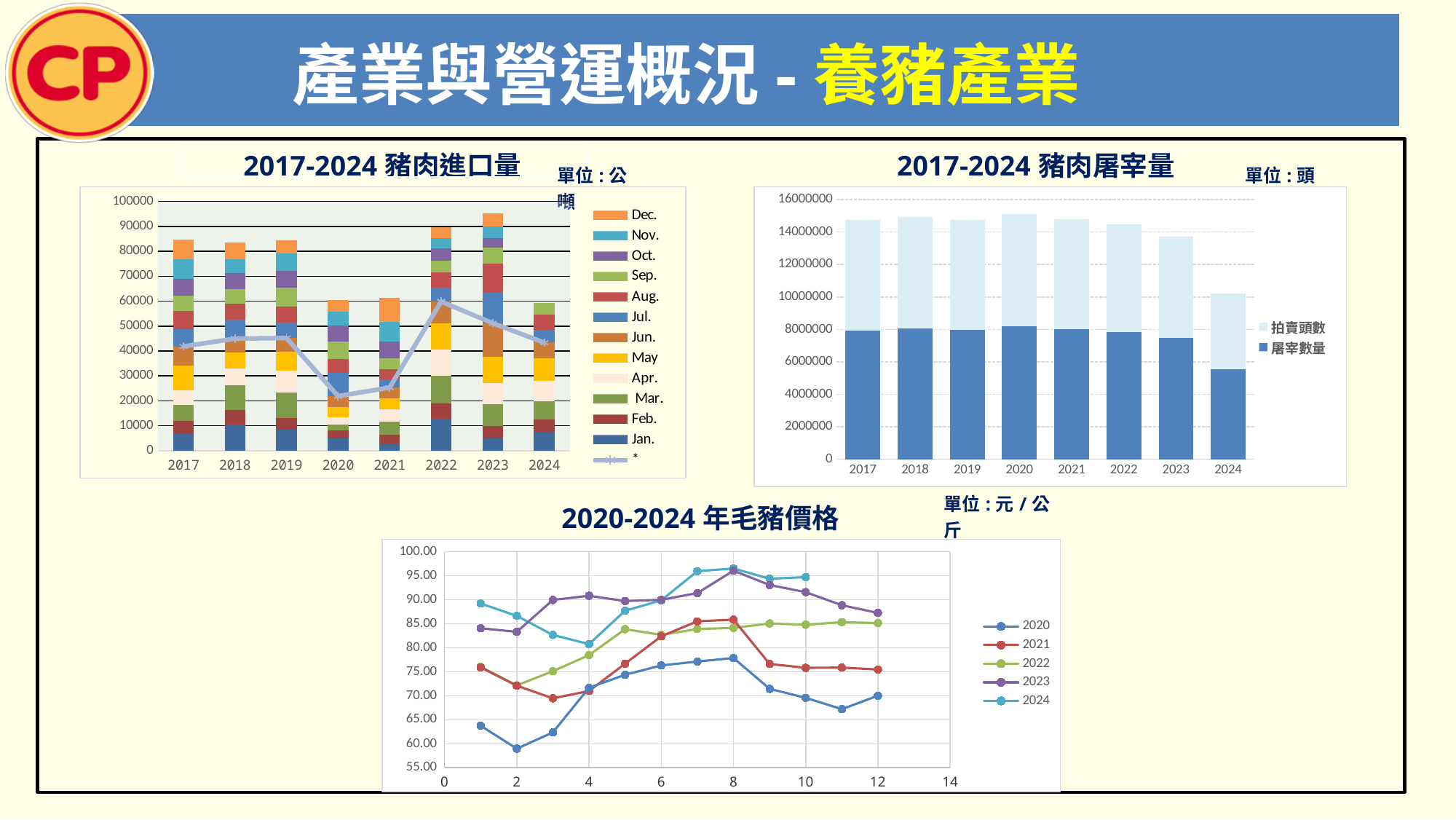
In the 2017-2024 豬肉進口量 chart, how many years are shown on the x axis? 8 How many series does the legend of the 2017-2024 豬肉屠宰量 chart list? 2 In the 2017-2024 豬肉進口量 chart, is the total for 2020 greater or less than 70000? less What kind of chart is the 2020-2024 年毛豬價格 chart? line chart In the 2017-2024 豬肉進口量 chart, which year has the highest total stacked bar? 2023 In the 2017-2024 豬肉屠宰量 chart, which year has the lowest total stacked bar? 2024 What unit is stated for the 2017-2024 豬肉屠宰量 chart? 頭 In the 2017-2024 豬肉屠宰量 chart, is the total for 2024 greater or less than 12000000? less What kind of chart is the 2017-2024 豬肉進口量 chart? combination bar and line chart (stacked bars with a line) In the 2020-2024 年毛豬價格 chart, is the 2020 value at month 2 greater or less than 60.00? less How many series does the legend of the 2020-2024 年毛豬價格 chart list? 5